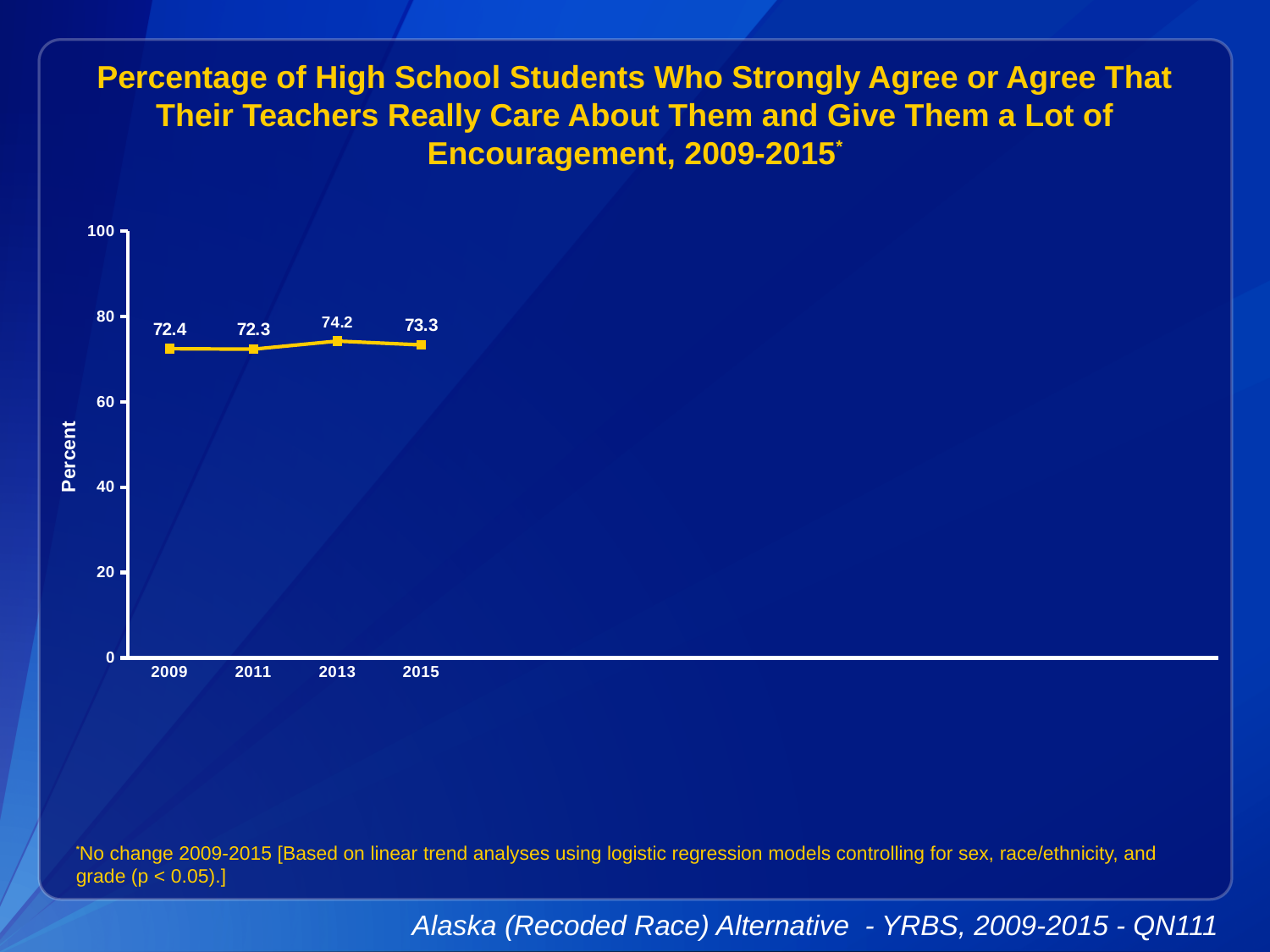
What is the difference between the values for 2015 and 2013? 0.9 Which year has the lowest value? 2011 Which is larger, the value for 2015 or the value for 2009? 2015 What is the value for 2013? 74.2 What is the label on the y axis? Percent What is the value for 2009? 72.4 What is the value for 2015? 73.3 Which year has the highest value? 2013 How many years are plotted on the chart? 4 Is the value for 2013 greater or less than 80? less What kind of chart is shown? line chart What is the difference between the values for 2013 and 2011? 1.9